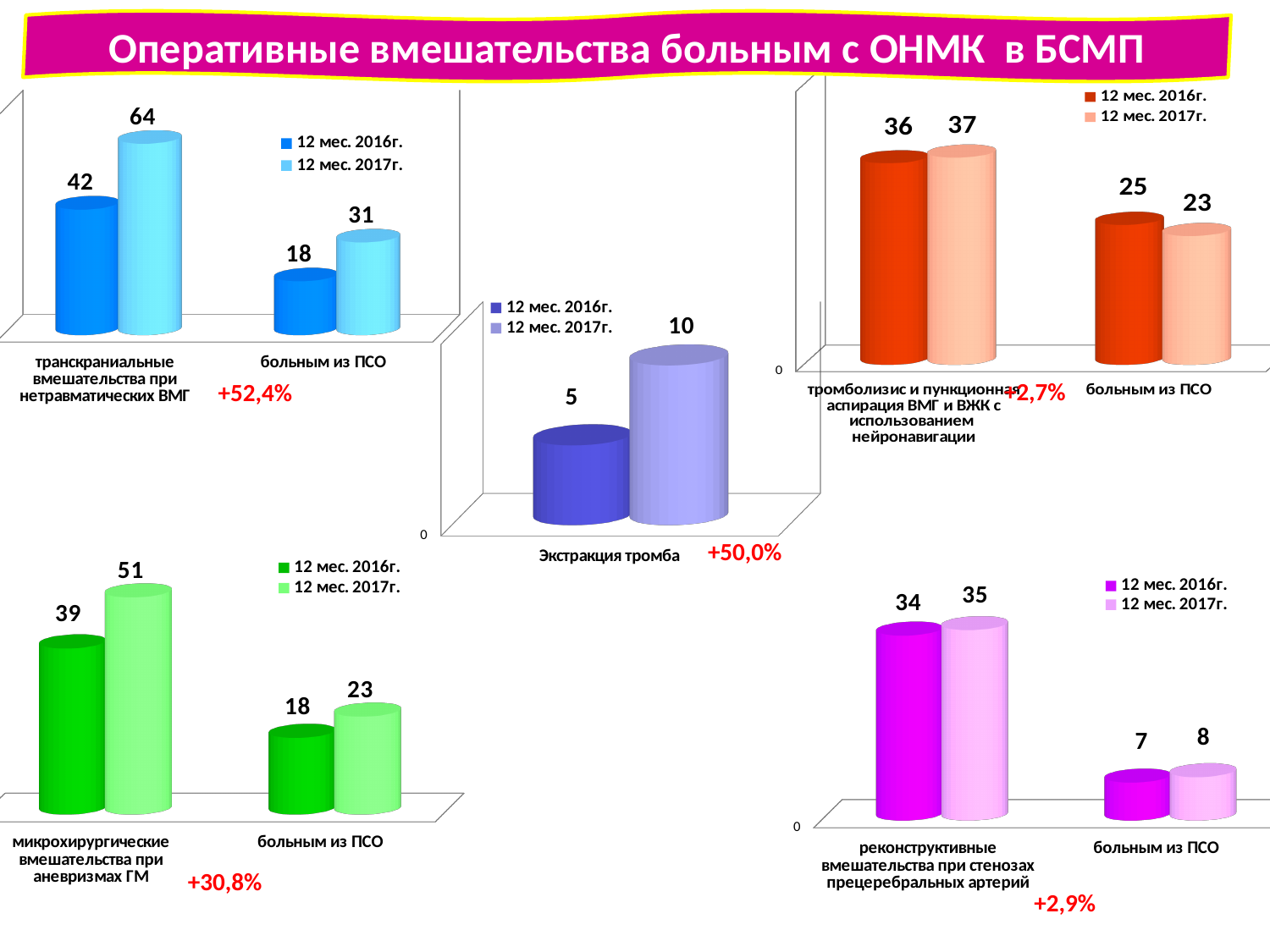
How many series does the legend of the bottom-right chart list? 2 In the center chart titled Экстракция тромба, what is the value for 12 мес. 2017г.? 10 In the bottom-right chart, what is the value for 12 мес. 2016г. for больным из ПСО? 7 In the top-left chart, what is the value for 12 мес. 2017г. for транскраниальные вмешательства при нетравматических ВМГ? 64 In the top-right chart, what is the value for 12 мес. 2017г. for больным из ПСО? 23 In the top-right chart, what is the value for 12 мес. 2016г. for тромболизис и пункционная аспирация ВМГ и ВЖК с использованием нейронавигации? 36 In the center chart titled Экстракция тромба, which series is larger, 12 мес. 2016г. or 12 мес. 2017г.? 12 мес. 2017г. In the top-left chart, what is the difference between the 2017 and 2016 values for транскраниальные вмешательства при нетравматических ВМГ? 22 In the bottom-left chart, what is the difference between the 2017 and 2016 values for больным из ПСО? 5 In the top-left chart, what is the value for 12 мес. 2016г. for больным из ПСО? 18 In the bottom-left chart, what is the value for 12 мес. 2017г. for микрохирургические вмешательства при аневризмах ГМ? 51 In the bottom-right chart, which category has the highest value? реконструктивные вмешательства при стенозах прецеребральных артерий